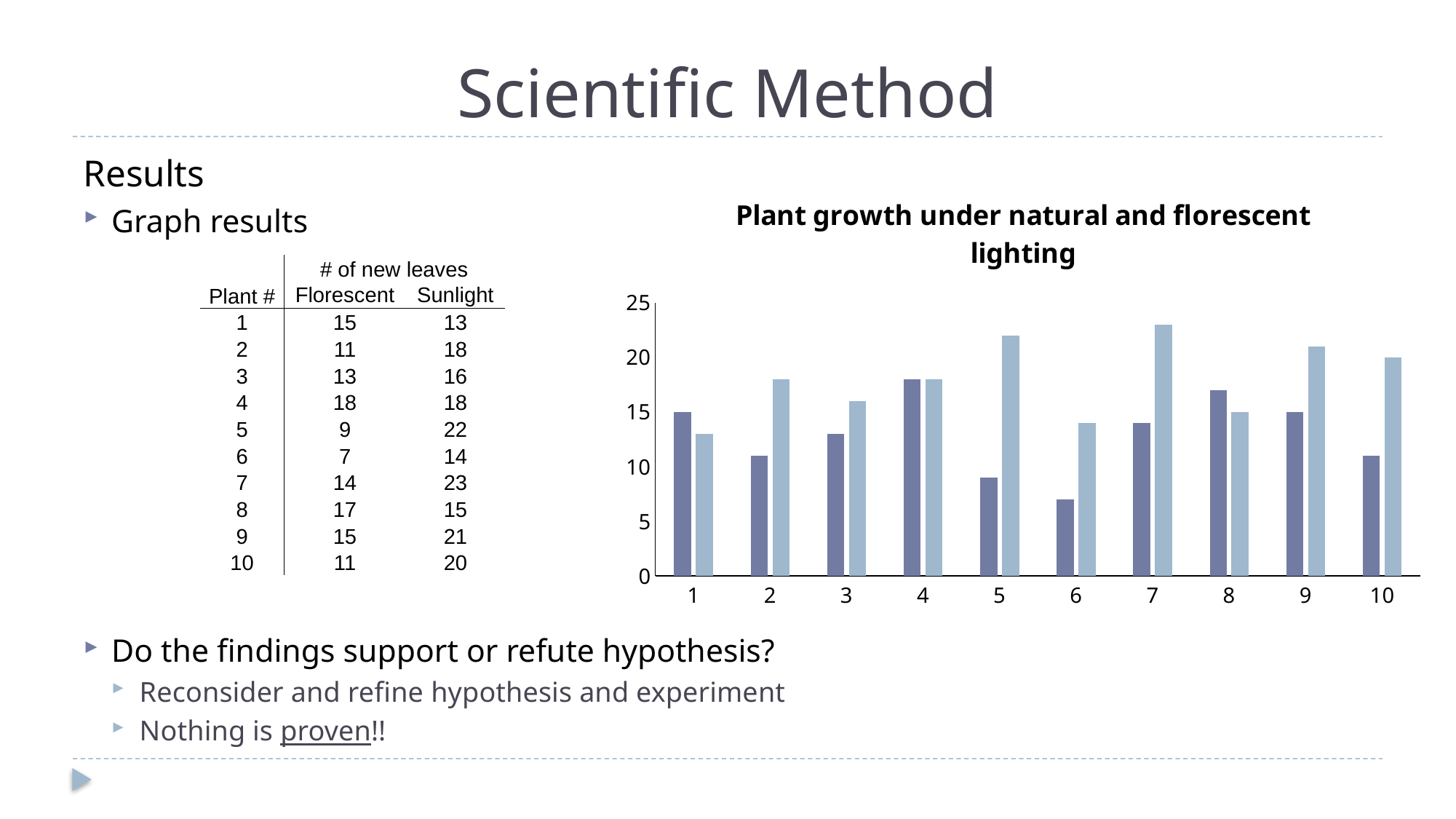
Is the value of the darker bar for plant 6 greater or less than 10? less For plant 8, which bar is taller, the darker bar or the lighter bar? the darker bar How many plants (categories) are shown on the x axis of the chart? 10 What is the title of the chart? Plant growth under natural and florescent lighting Which plant has the shortest darker bar? 6 For plant 2, which bar is taller, the darker bar or the lighter bar? the lighter bar What kind of chart is shown on the slide? bar chart What is the value of the lighter bar for plant 10? 20 Is the value of the lighter bar for plant 5 greater or less than 20? greater Using the table values, what is the difference between the Sunlight and Florescent values for plant 5? 13 What is the value of the lighter bar for plant 8? 15 What is the value of the darker bar for plant 1? 15